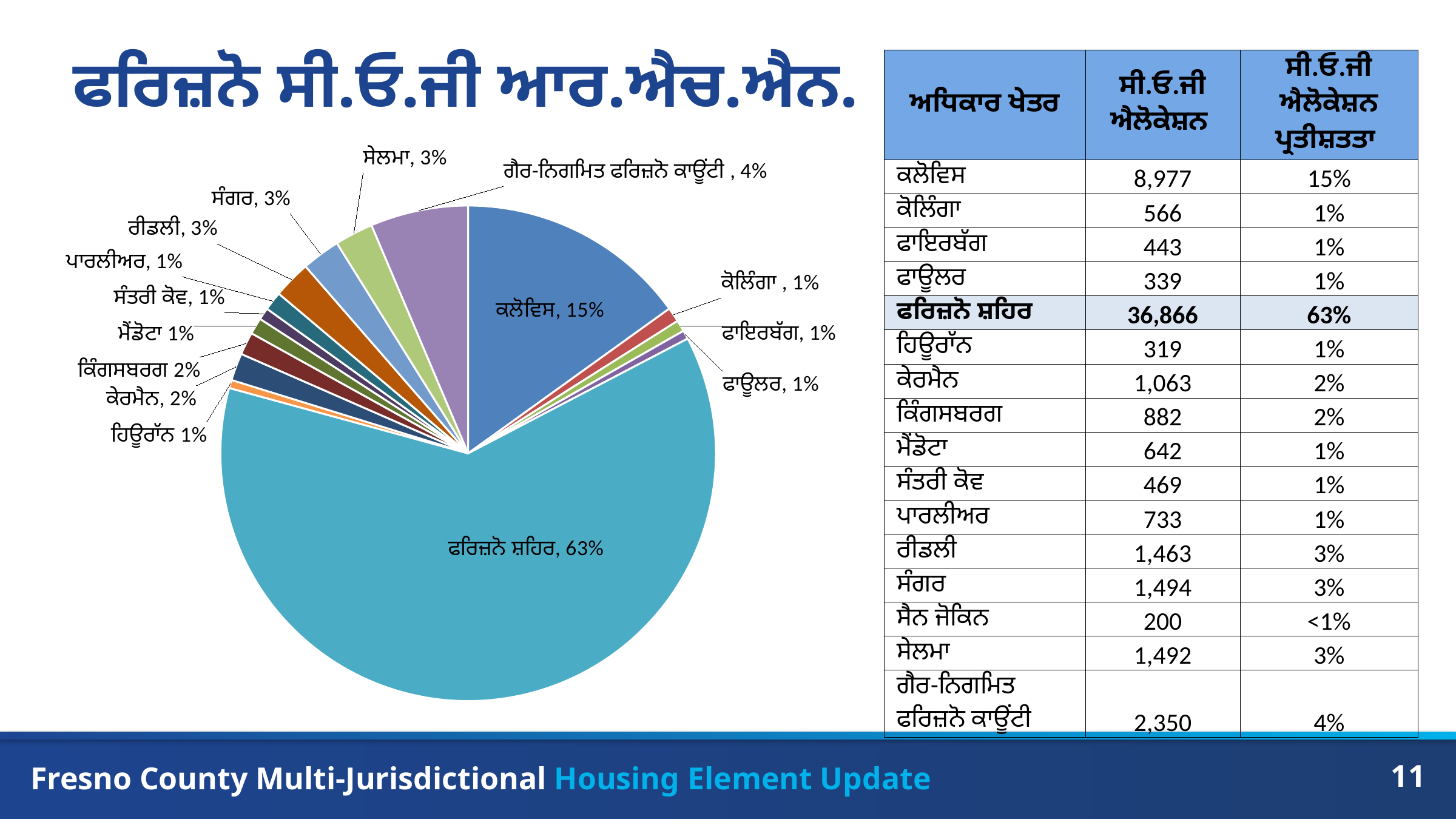
What is the difference in percentage points between the ਗੈਰ-ਨਿਗਮਿਤ ਫਰਿਜ਼ਨੋ ਕਾਊਂਟੀ slice and the ਰੀਡਲੀ slice in the pie chart? 1 percentage point In the pie chart, what share is shown for ਫਰਿਜ਼ਨੋ ਸ਼ਹਿਰ? 63% Which slice of the pie chart is the largest? ਫਰਿਜ਼ਨੋ ਸ਼ਹਿਰ What kind of chart is shown on the slide? pie chart What is the difference in percentage points between the ਫਰਿਜ਼ਨੋ ਸ਼ਹਿਰ slice and the ਕਲੋਵਿਸ slice in the pie chart? 48 percentage points In the pie chart, what share is shown for ਕਿੰਗਸਬਰਗ? 2% In the pie chart, what share is shown for ਗੈਰ-ਨਿਗਮਿਤ ਫਰਿਜ਼ਨੋ ਕਾਊਂਟੀ? 4% In the pie chart, which is larger: the slice for ਕੇਰਮੈਨ or the slice for ਹਿਊਰੌਨ? ਕੇਰਮੈਨ In the pie chart, which is larger: the slice for ਕਲੋਵਿਸ or the slice for ਸੰਗਰ? ਕਲੋਵਿਸ What colour is the ਫਰਿਜ਼ਨੋ ਸ਼ਹਿਰ slice in the pie chart? teal